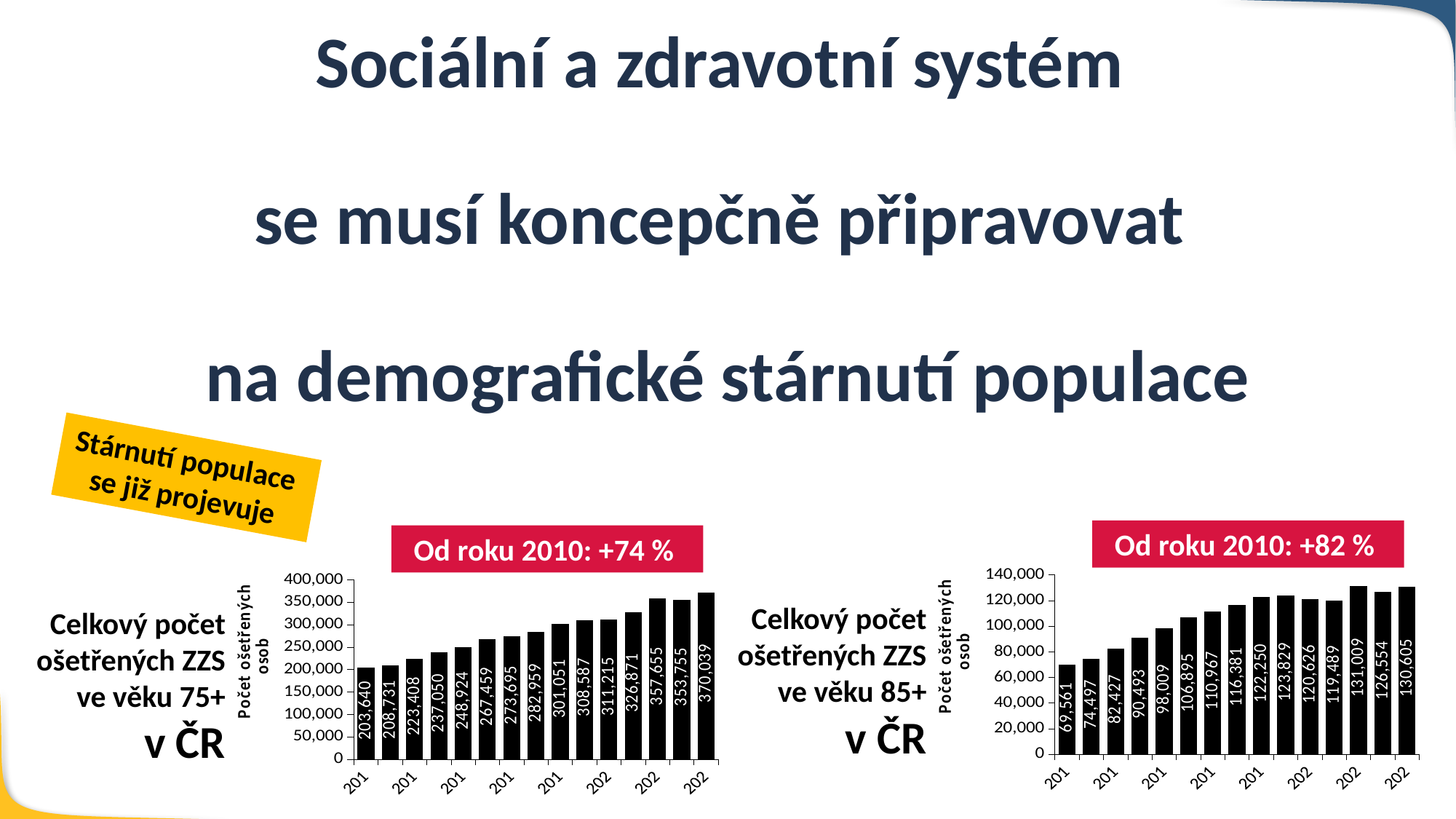
What percentage increase since 2010 is stated in the red box above the left chart (ošetřených ZZS ve věku 75+)? +74 % What type of chart is the left chart (ošetřených ZZS ve věku 75+)? Bar chart In the right chart (ošetřených ZZS ve věku 85+), what is the value of the tallest bar? 131,009 In the left chart (ošetřených ZZS ve věku 75+), what is the difference between the last bar and the first bar? 166,399 In the left chart (ošetřených ZZS ve věku 75+), how many bars are plotted? 15 In the left chart (ošetřených ZZS ve věku 75+), what is the value of the shortest bar? 203,640 In the right chart (ošetřených ZZS ve věku 85+), what is the value of the last bar? 130,605 In the left chart (ošetřených ZZS ve věku 75+), what is the value of the tallest bar? 370,039 In the right chart (ošetřených ZZS ve věku 85+), what is the value of the shortest bar? 69,561 In the right chart (ošetřených ZZS ve věku 85+), do the values generally rise or fall from left to right? Rise In the right chart (ošetřených ZZS ve věku 85+), what is the difference between the last bar and the first bar? 61,044 In the right chart (ošetřených ZZS ve věku 85+), how many bars are plotted? 15